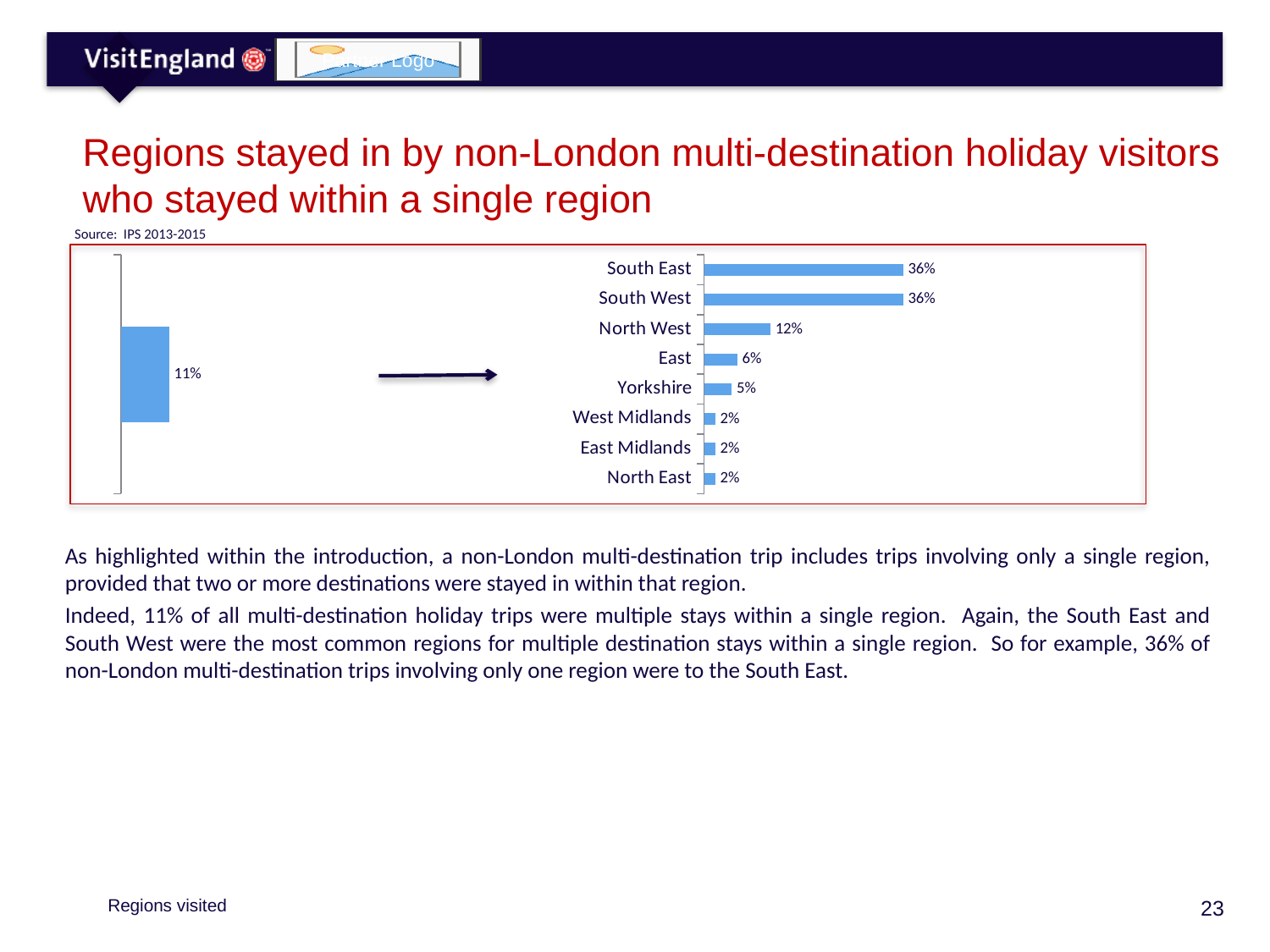
In the bar chart on the right, what is the value for the West Midlands? 2% In the bar chart on the right, what is the difference between the North West and Yorkshire? 7% In the bar chart on the right, what is the difference between the South East and the North West? 24% What value is labelled on the single bar in the small chart on the left of the slide? 11% What kind of chart is the chart on the right of the slide? Bar chart How many regions are shown in the bar chart on the right? 8 In the bar chart on the right, what is the value for the South East? 36% In the bar chart on the right, what is the value for the North West? 12% In the bar chart on the right, what is the value for the East? 6% In the bar chart on the right, which two regions share the highest value? South East and South West In the bar chart on the right, which is larger, the value for the North West or the value for the East? North West In the bar chart on the right, what is the value for Yorkshire? 5%